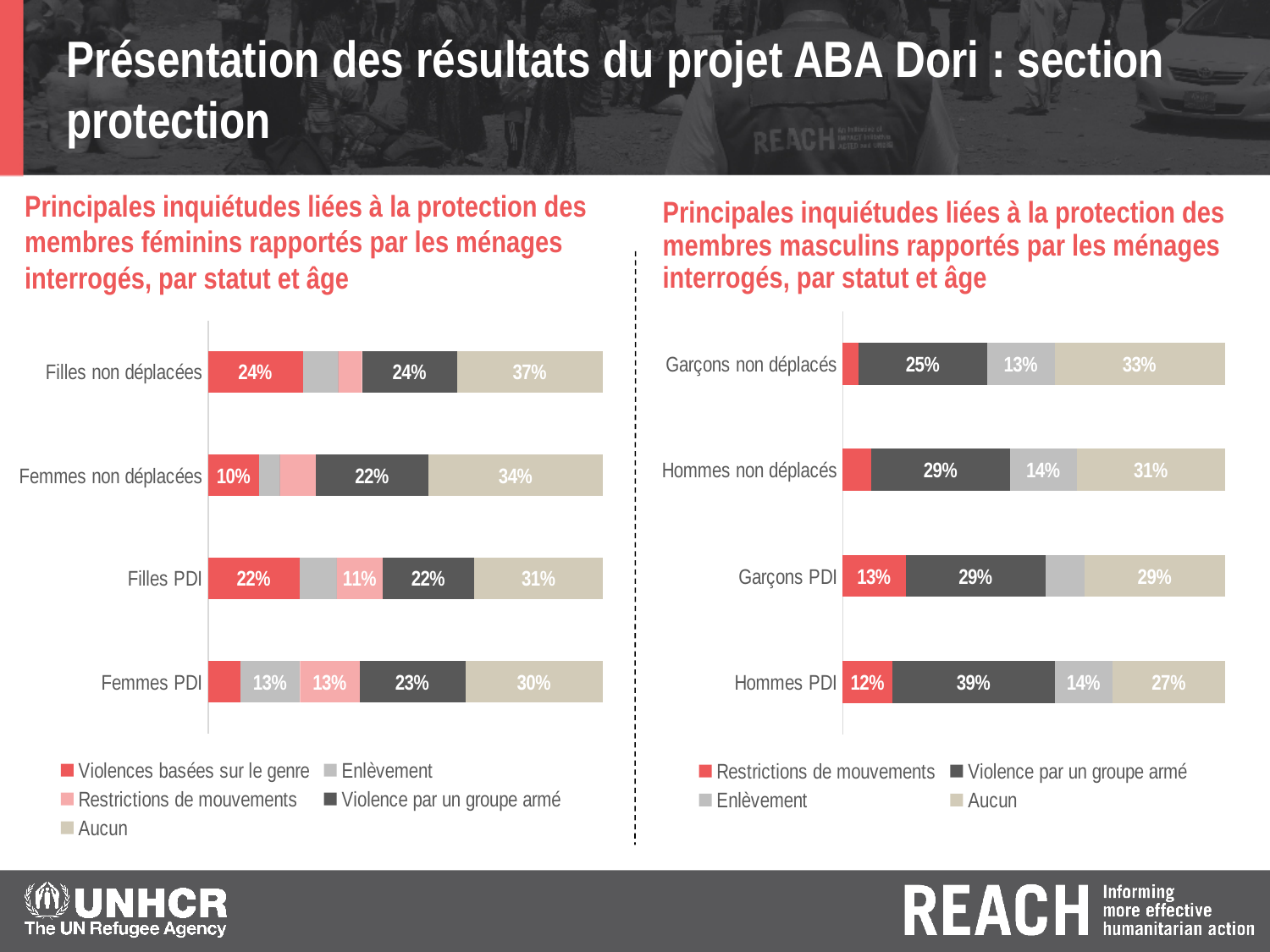
How many categories are shown on the y axis of the left chart (membres féminins)? 4 In the left chart (membres féminins), which category has the highest 'Aucun' value? Filles non déplacées In the right chart (membres masculins), which category has the highest 'Violence par un groupe armé' value? Hommes PDI In the left chart (membres féminins), what is the difference between the 'Aucun' values for Filles non déplacées and Femmes PDI? 7% In the right chart (membres masculins), which is larger: the 'Violence par un groupe armé' value for Hommes PDI or for Garçons PDI? Hommes PDI In the left chart (membres féminins), what is the 'Aucun' value for Femmes non déplacées? 34% How many series does the legend of the right chart (membres masculins) list? 4 In the left chart (membres féminins), what is the value for 'Violences basées sur le genre' for Filles non déplacées? 24% In the right chart (membres masculins), what is the value for 'Violence par un groupe armé' for Hommes PDI? 39% In the right chart (membres masculins), which category has the lowest 'Aucun' value? Hommes PDI In the right chart (membres masculins), what is the 'Enlèvement' value for Garçons non déplacés? 13% What type of chart is the left chart (membres féminins)? Stacked bar chart